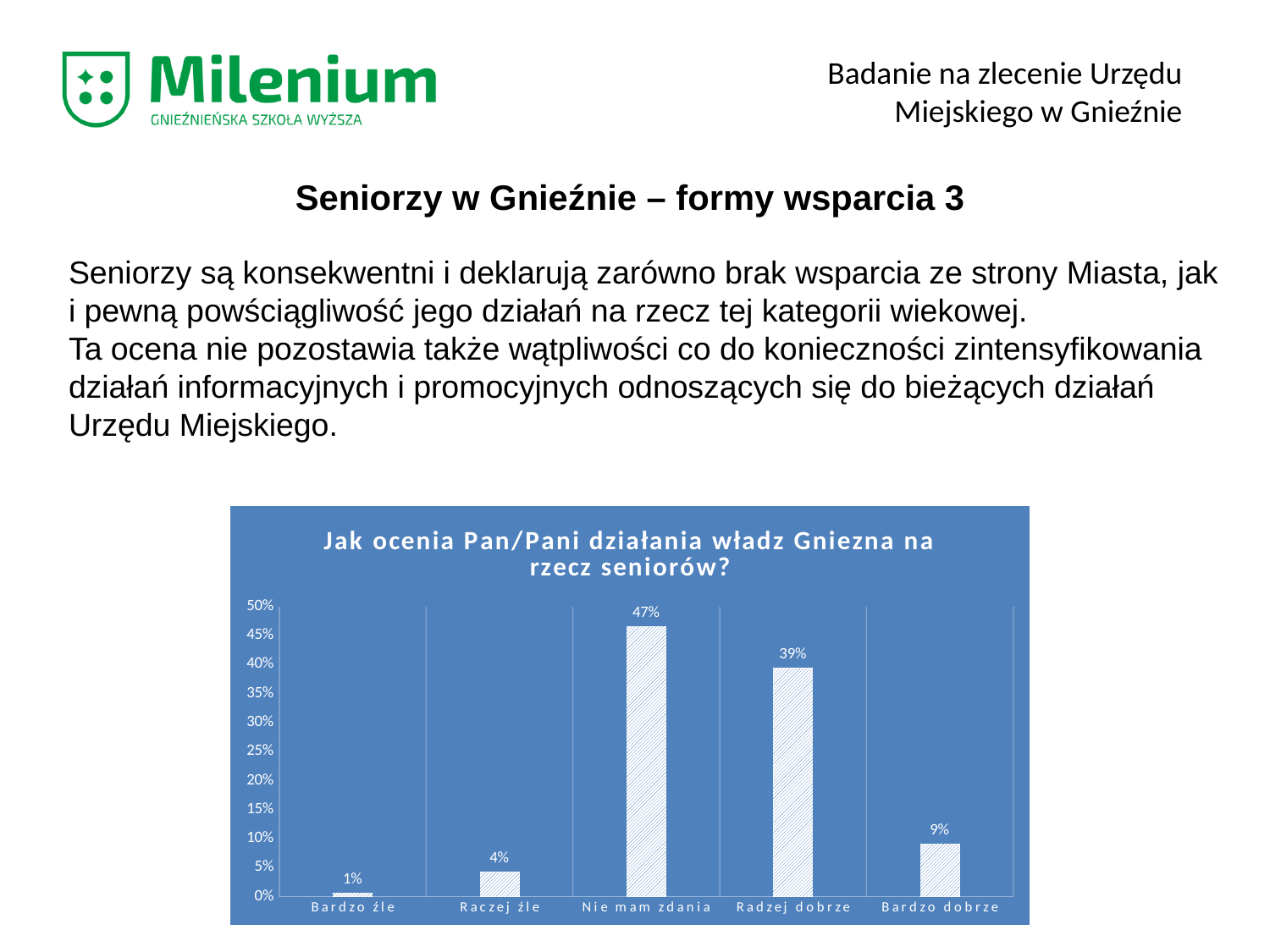
What is the value for "Nie mam zdania"? 47% What kind of chart is shown on the slide? bar chart Is the value for "Radzej dobrze" greater or less than 35%? greater What is the value for "Raczej źle"? 4% What is the value for "Bardzo dobrze"? 9% Which category has the lowest value? Bardzo źle Which is larger, the value for "Bardzo dobrze" or the value for "Raczej źle"? Bardzo dobrze What is the difference between the values for "Nie mam zdania" and "Radzej dobrze"? 8% What is the value for "Radzej dobrze"? 39% How many categories are shown on the x axis? 5 Which category has the highest value? Nie mam zdania What is the title of the chart? Jak ocenia Pan/Pani działania władz Gniezna na rzecz seniorów?